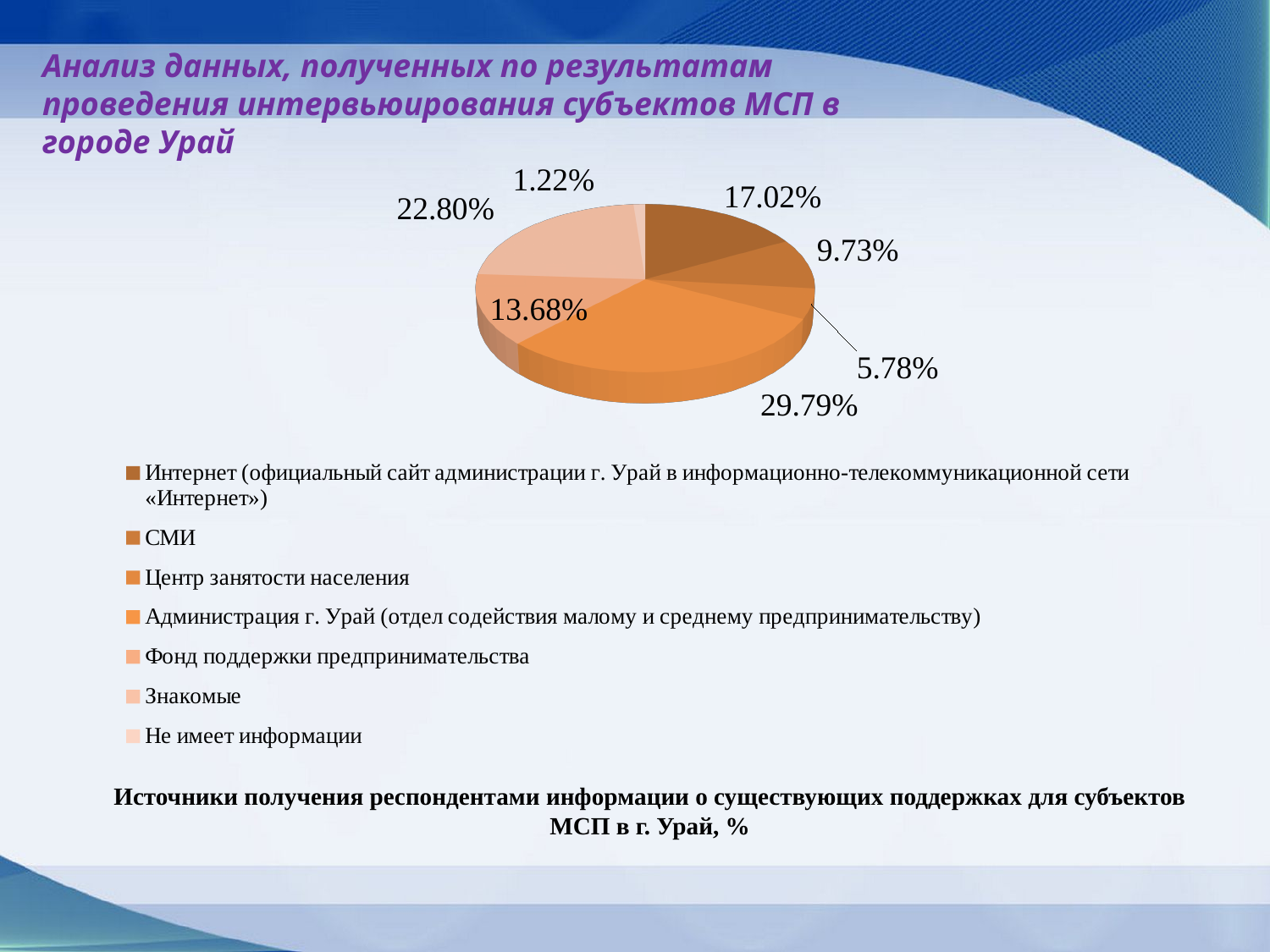
What is the difference between the shares for «Администрация г. Урай» and «Знакомые»? 6.99% What is the caption below the legend of the chart? Источники получения респондентами информации о существующих поддержках для субъектов МСП в г. Урай, % What share of respondents named «Администрация г. Урай (отдел содействия малому и среднему предпринимательству)» as their source of information? 29.79% What is the value for «Фонд поддержки предпринимательства»? 13.68% What percentage corresponds to «Интернет (официальный сайт администрации г. Урай в информационно-телекоммуникационной сети «Интернет»)»? 17.02% What is the value for «Знакомые»? 22.80% Which category has the smallest share in the pie chart? Не имеет информации What type of chart is shown on the slide? Pie chart Which is larger: the share for «СМИ» or the share for «Центр занятости населения»? СМИ How many slices does the pie chart have? 7 What is the value for «СМИ»? 9.73% Which source of information has the largest share in the pie chart? Администрация г. Урай (отдел содействия малому и среднему предпринимательству)